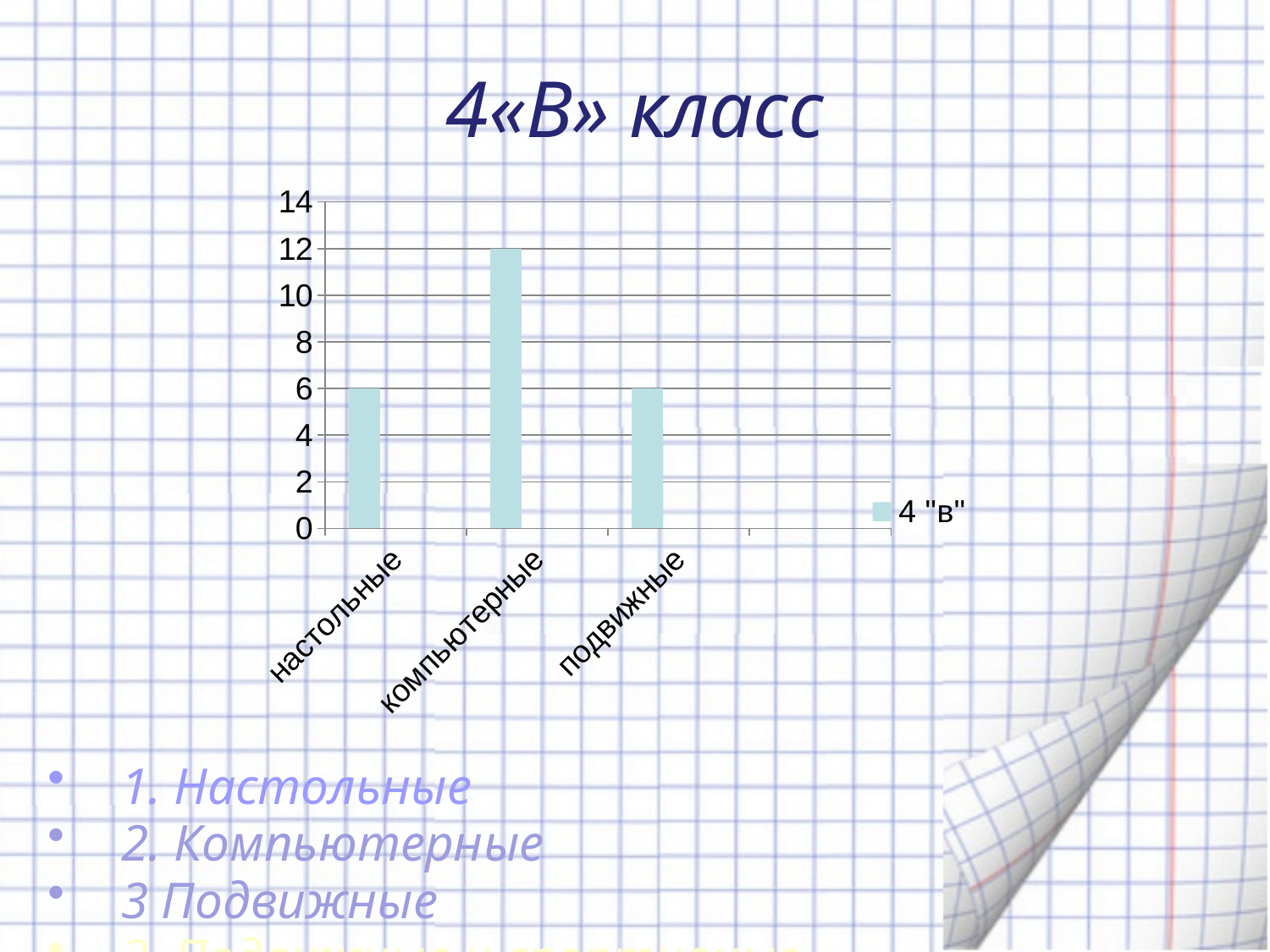
What kind of chart is shown on the slide? bar chart What is the difference between the values for компьютерные and настольные? 6 Which category has the highest value? компьютерные How many series does the chart legend list? 1 What is the name of the series shown in the chart legend? 4 "в" What is the value for компьютерные? 12 Is the value for компьютерные greater or less than 10? greater What is the highest value shown on the y axis of the chart? 14 What is the value for подвижные? 6 What is the value for настольные? 6 How many categories are shown on the x axis of the chart? 3 Which is larger, the value for компьютерные or the value for подвижные? компьютерные